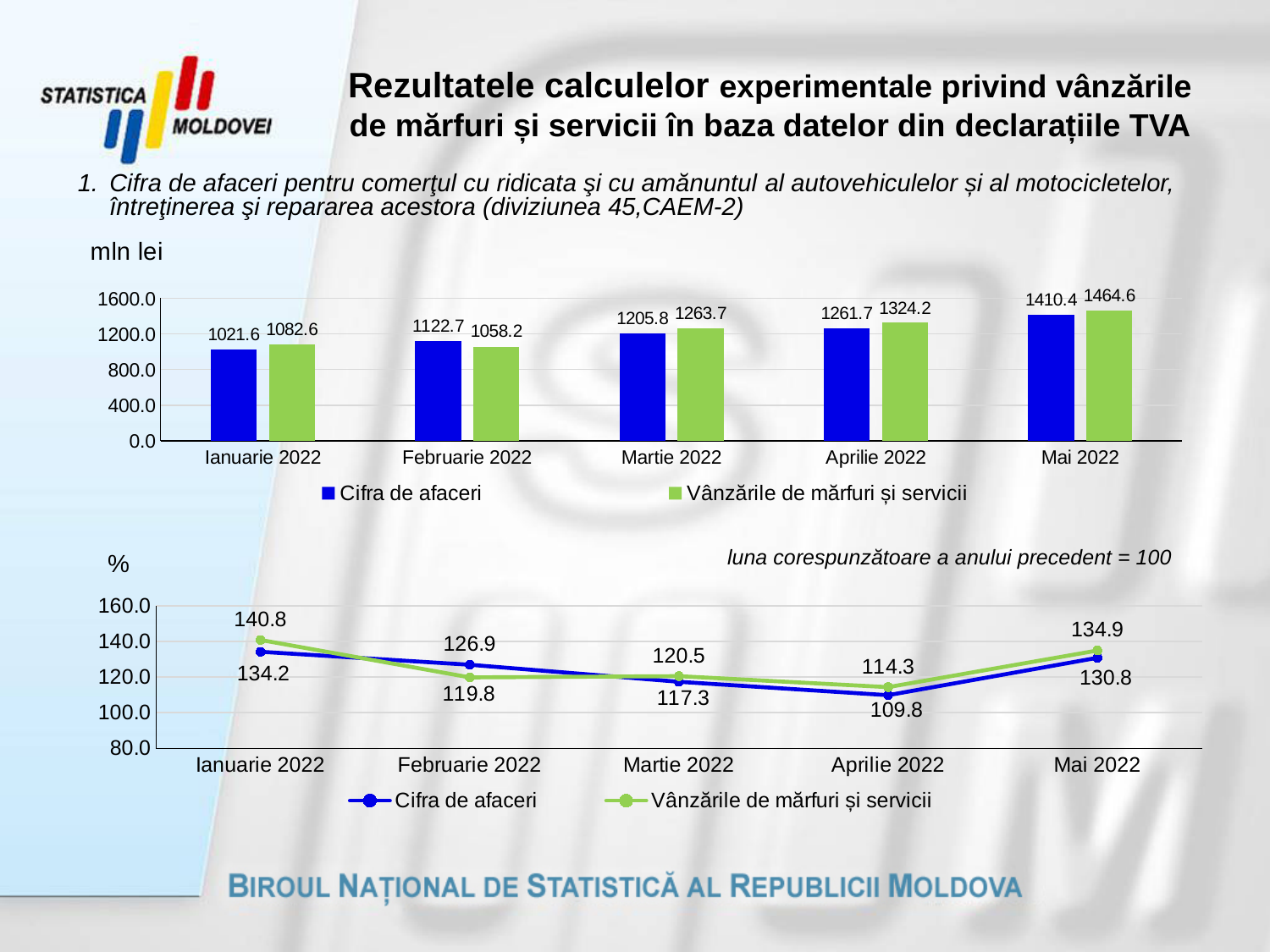
How many series does the legend of the top bar chart list? 2 In the top bar chart (mln lei), which month has the highest value for Vânzările de mărfuri și servicii? Mai 2022 In the top bar chart (mln lei), what is the value of Vânzările de mărfuri și servicii for Mai 2022? 1464.6 In the bottom line chart (%), which month has the lowest value for Vânzările de mărfuri și servicii? Aprilie 2022 In the top bar chart (mln lei), which month has the lowest value for Cifra de afaceri? Ianuarie 2022 In the top bar chart (mln lei), what is the difference between Vânzările de mărfuri și servicii and Cifra de afaceri for Mai 2022? 54.2 In the top bar chart (mln lei), which is larger for Februarie 2022: Cifra de afaceri or Vânzările de mărfuri și servicii? Cifra de afaceri What kind of chart is the top chart (mln lei)? Bar chart How many months are shown on the x axis of the bottom line chart (%)? 5 In the bottom line chart (%), what is the value of Vânzările de mărfuri și servicii for Ianuarie 2022? 140.8 In the top bar chart (mln lei), what is the value of Cifra de afaceri for Martie 2022? 1205.8 In the bottom line chart (%), what is the value of Cifra de afaceri for Aprilie 2022? 109.8